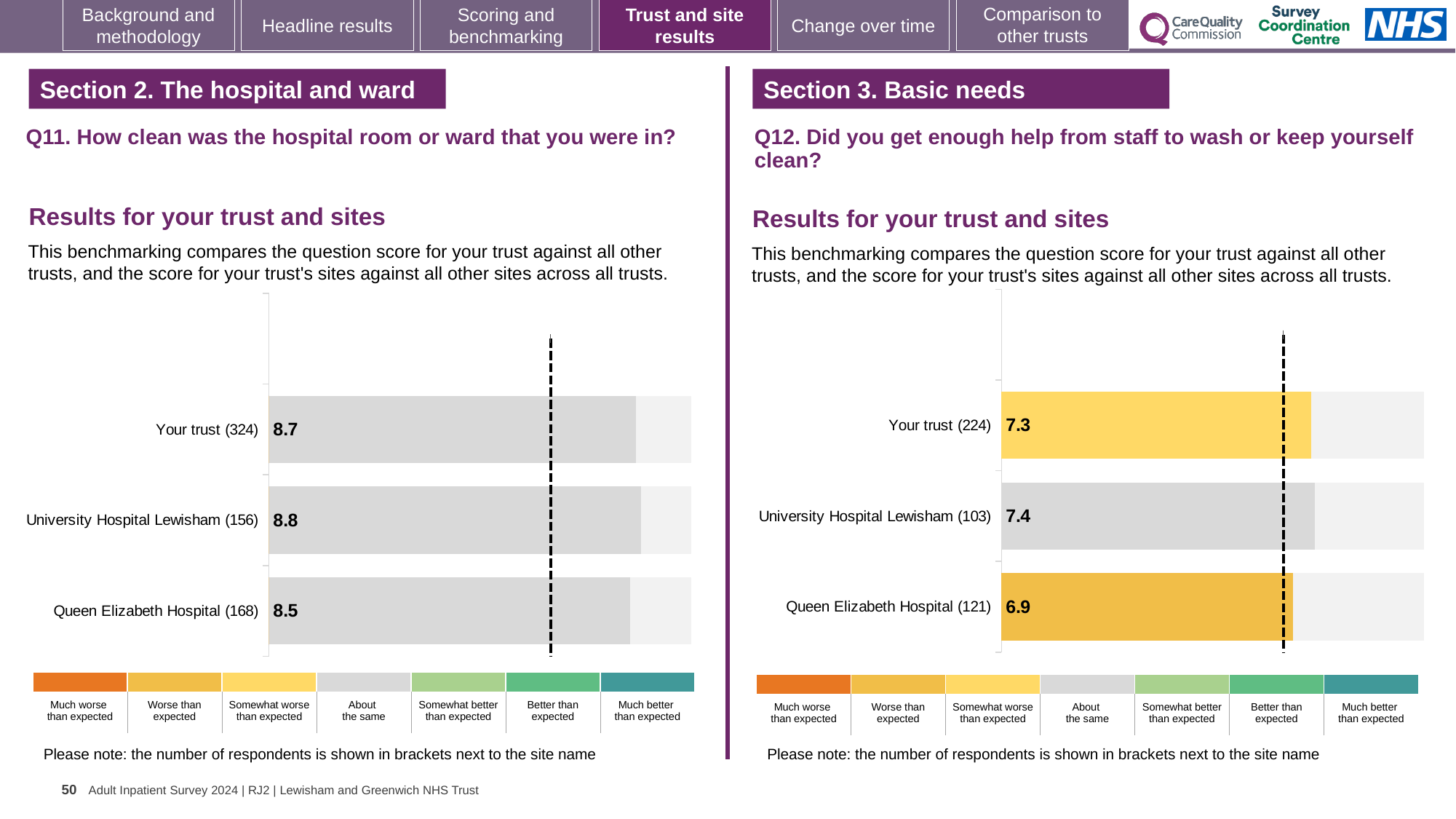
In the Q12 chart (right), what benchmark category does the colour of the Queen Elizabeth Hospital (121) bar correspond to in the legend? Worse than expected In the Q11 chart (left), what is the difference between the scores for University Hospital Lewisham (156) and Queen Elizabeth Hospital (168)? 0.3 What kind of chart is the Q12 chart (right)? Bar chart In the Q11 chart (left), which category has the highest score? University Hospital Lewisham (156) In the Q11 chart (left), how many categories are plotted? 3 In the Q12 chart (right), what is the difference between the scores for University Hospital Lewisham (103) and Queen Elizabeth Hospital (121)? 0.5 In the Q12 chart (right), which category has the lowest score? Queen Elizabeth Hospital (121) In the Q11 chart (left), what is the score for Queen Elizabeth Hospital (168)? 8.5 In the Q12 chart (right), which is larger: the score for Your trust (224) or Queen Elizabeth Hospital (121)? Your trust (224) In the Q12 chart (right), what is the score for Your trust (224)? 7.3 In the Q12 chart (right), what is the score for University Hospital Lewisham (103)? 7.4 In the Q11 chart (left), what is the score for Your trust (324)? 8.7